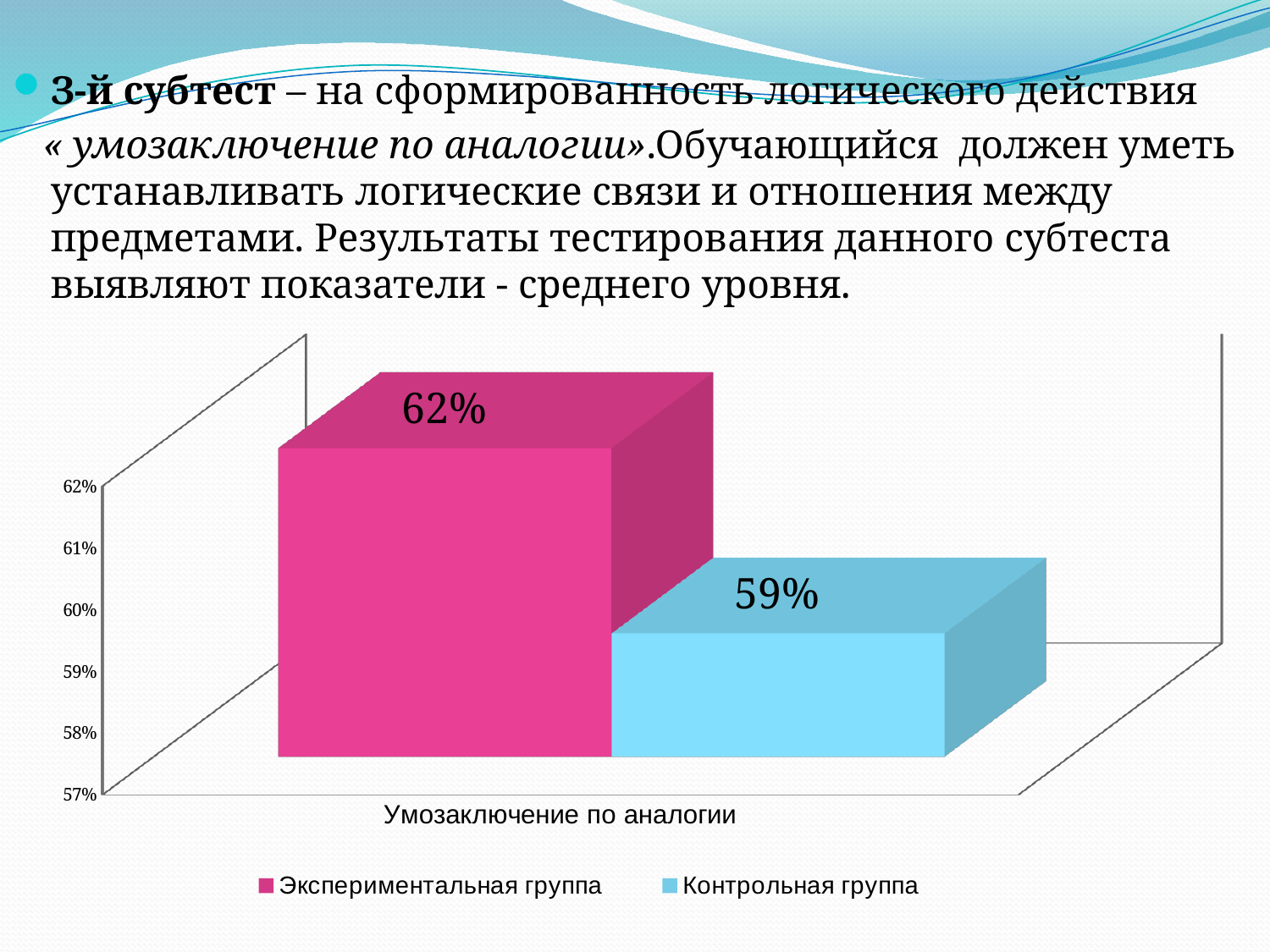
Which series has the higher value in the chart? Экспериментальная группа Is the value for Контрольная группа greater or less than 60%? less How many series does the legend list? 2 What is the value for Экспериментальная группа in the chart? 62% Which series has the lower value in the chart? Контрольная группа What is the value for Контрольная группа in the chart? 59% Is the value for Экспериментальная группа larger or smaller than the value for Контрольная группа? larger Is the value for Экспериментальная группа greater or less than 60%? greater What is the category label on the x axis of the chart? Умозаключение по аналогии How many categories are shown on the x axis of the chart? 1 What kind of chart is shown on the slide? bar chart What is the difference between the values for Экспериментальная группа and Контрольная группа? 3%